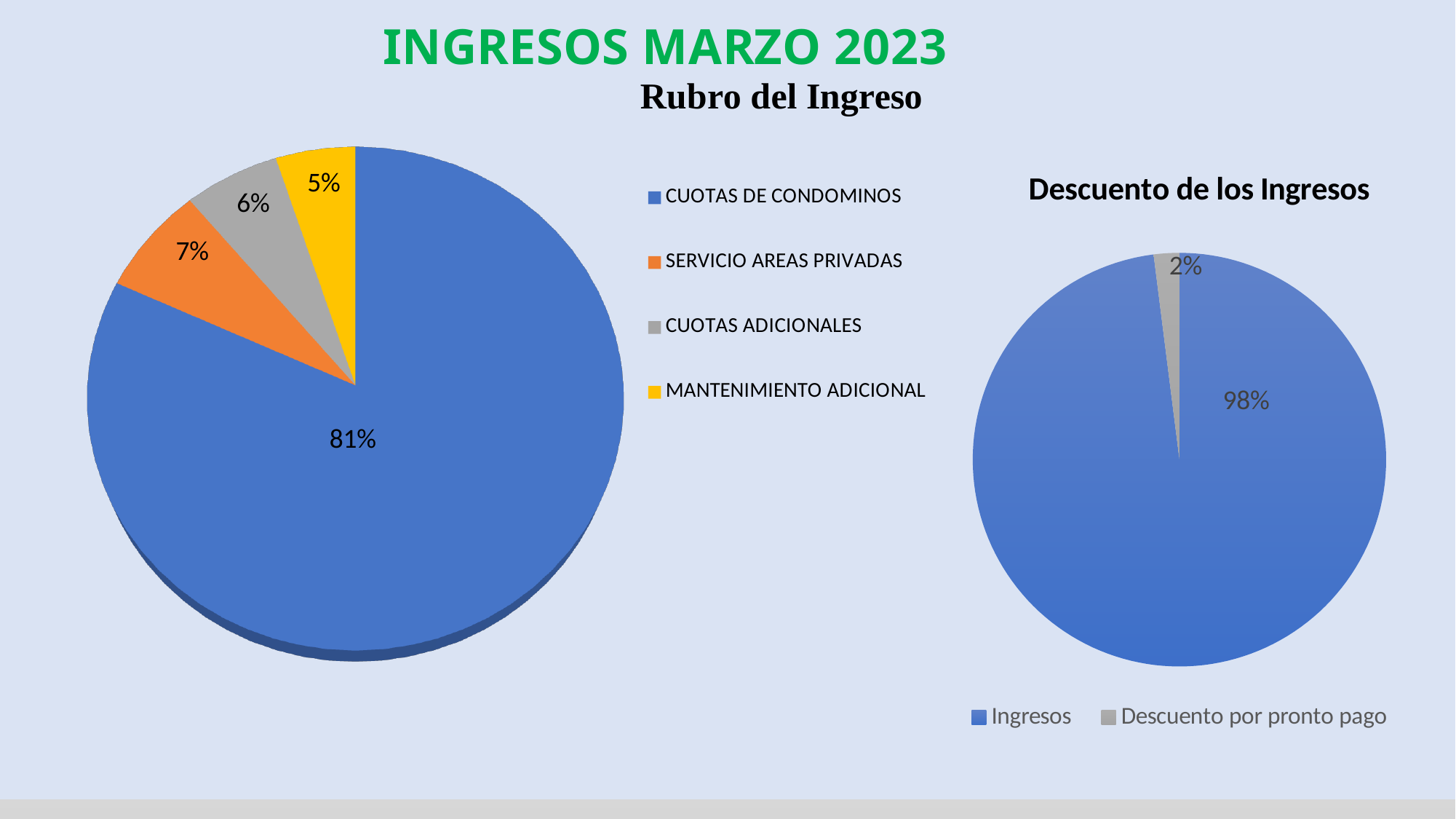
In the 'Rubro del Ingreso' chart, what share does MANTENIMIENTO ADICIONAL have? 5% In the 'Rubro del Ingreso' chart, which category has the largest slice? CUOTAS DE CONDOMINOS In the 'Rubro del Ingreso' chart, what share does SERVICIO AREAS PRIVADAS have? 7% In the 'Rubro del Ingreso' chart, what is the difference in percentage points between CUOTAS DE CONDOMINOS and SERVICIO AREAS PRIVADAS? 74 What kind of chart is 'Descuento de los Ingresos'? Pie chart In the 'Rubro del Ingreso' chart, what share does CUOTAS ADICIONALES have? 6% In the 'Rubro del Ingreso' chart, how many categories are shown? 4 In the 'Rubro del Ingreso' chart, which category has the smallest slice? MANTENIMIENTO ADICIONAL In the 'Rubro del Ingreso' chart, what colour is the MANTENIMIENTO ADICIONAL slice? Yellow